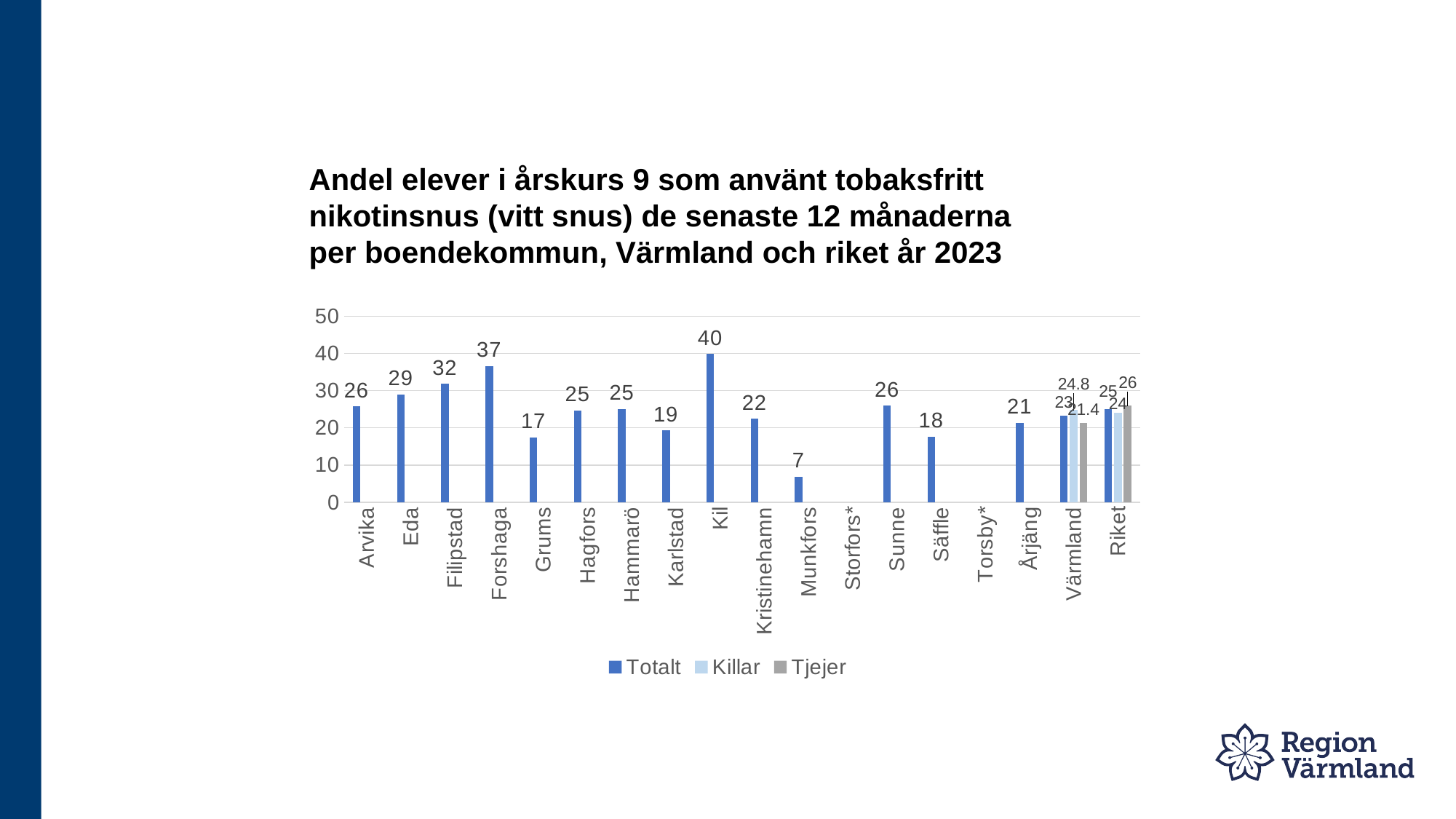
Which has a higher Totalt value, Filipstad or Eda? Filipstad Which municipality has the highest Totalt value? Kil How many categories are shown on the x axis? 18 How many series does the legend list? 3 What is the Tjejer value for Riket? 26 What is the difference between the Totalt values for Forshaga and Grums? 20 What is the Killar value for Värmland? 24.8 What is the Totalt value for Munkfors? 7 What is the Totalt value for Kil? 40 Is the Totalt value for Karlstad greater or less than 20? less What kind of chart is shown on the slide? Bar chart Among the municipalities with a plotted bar, which has the lowest Totalt value? Munkfors